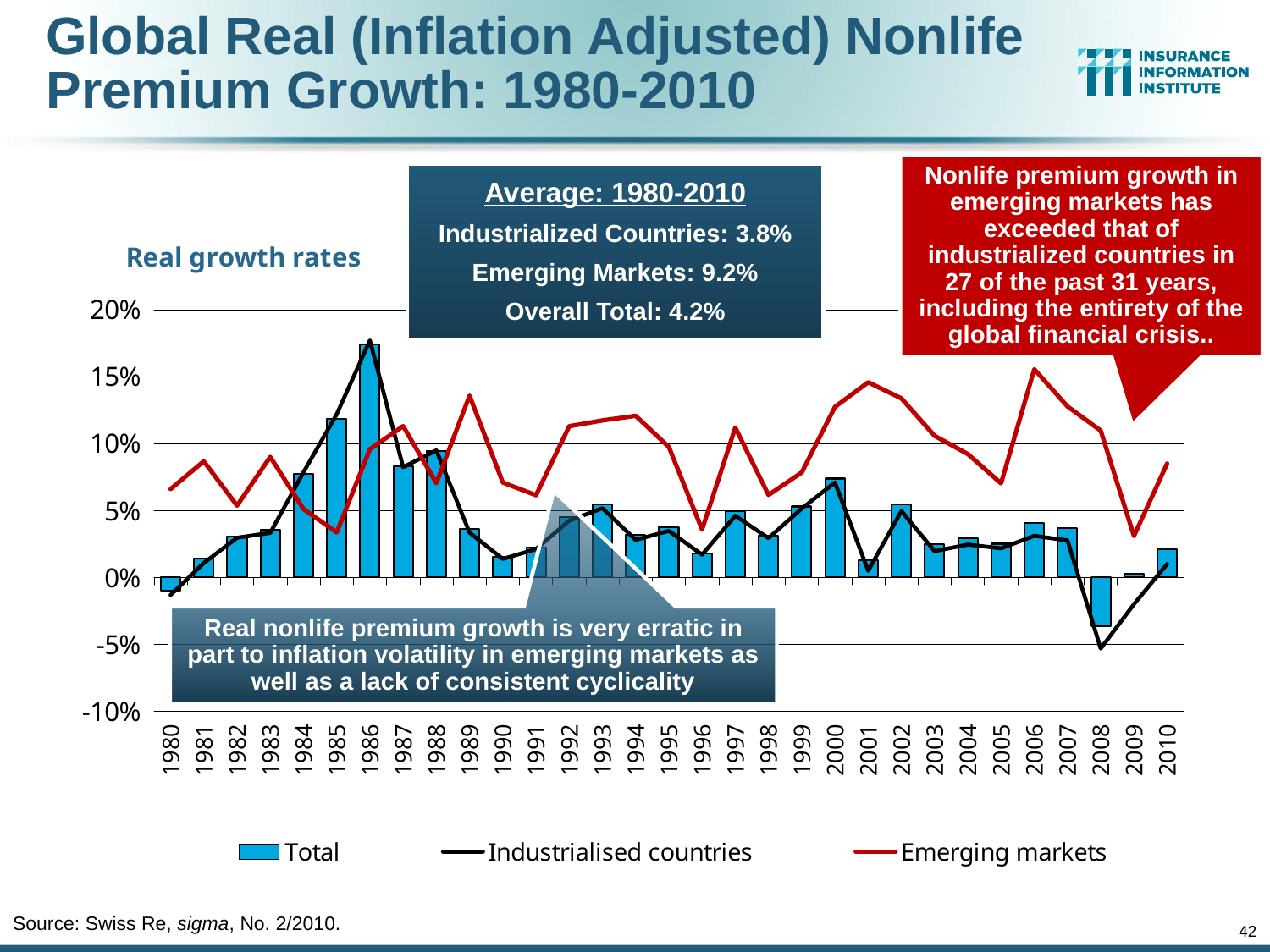
Does the Total series rise or fall from 1983 to 1986? Rise What colour is the Emerging markets line in the chart? Red How many series does the chart legend list? 3 Which is larger in 2001, the Emerging markets value or the Industrialised countries value? Emerging markets In which year is the Total bar the highest? 1986 How many years are plotted along the x axis of the chart? 31 What kind of chart is shown on the slide? A combination bar and line chart Is the Emerging markets value for 1996 greater or less than 5%? less In which year is the Total bar the lowest? 2008 In which year does the Industrialised countries line reach its highest value? 1986 Is the Total value for 1986 greater or less than 15%? greater Is the Total value for 2008 greater or less than 0%? less